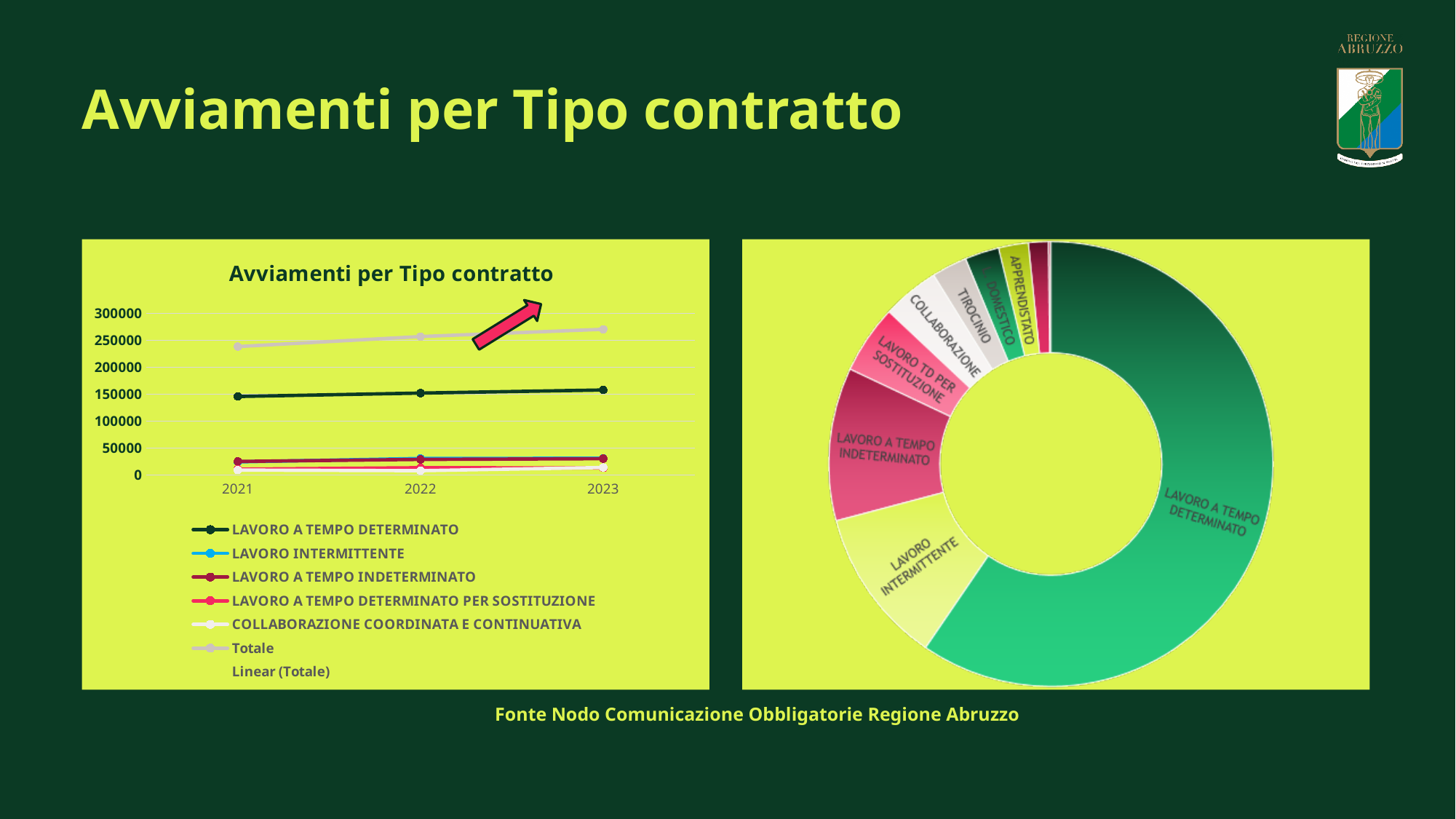
In the left line chart, is the value of LAVORO A TEMPO DETERMINATO in 2023 greater or less than 200000? less What type of chart is the left chart titled 'Avviamenti per Tipo contratto'? line chart In the left line chart, does the Totale series rise or fall from 2021 to 2023? rises In the left line chart, which series has the highest values across all years? Totale In the left line chart, is the value of Totale in 2021 greater or less than 250000? less In the right doughnut chart, which slice is larger: LAVORO A TEMPO DETERMINATO or LAVORO INTERMITTENTE? LAVORO A TEMPO DETERMINATO What is the title of the left line chart? Avviamenti per Tipo contratto In the left line chart, is the value of Totale in 2023 greater or less than 250000? greater In the left line chart, how many years are shown on the x axis? 3 In the left line chart, how many entries does the legend list? 7 What type of chart is shown on the right side of the slide? doughnut chart In the right doughnut chart, which contract type has the largest slice? LAVORO A TEMPO DETERMINATO